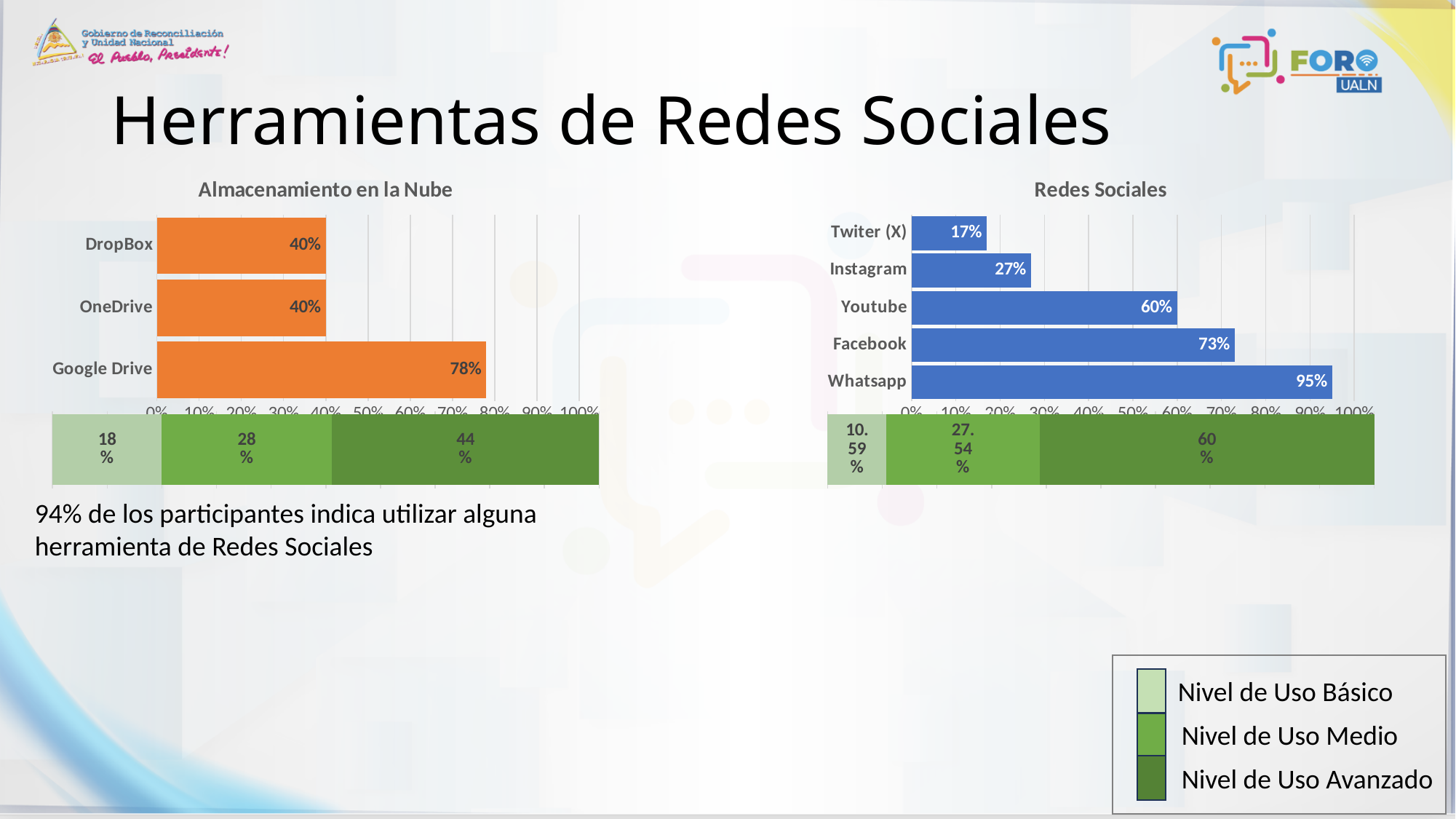
In the 'Redes Sociales' chart, what is the value for Instagram? 27% In the 'Redes Sociales' chart, what is the difference between Whatsapp and Youtube? 35% In the 'Almacenamiento en la Nube' chart, what is the difference between Google Drive and DropBox? 38% In the 'Almacenamiento en la Nube' chart, what is the value for Google Drive? 78% In the 'Redes Sociales' chart, which category has the highest value? Whatsapp In the 'Redes Sociales' chart, what is the value for Facebook? 73% In the 'Redes Sociales' chart, which category has the lowest value? Twiter (X) In the 'Redes Sociales' chart, which is larger, Youtube or Facebook? Facebook In the 'Almacenamiento en la Nube' chart, what is the value for OneDrive? 40% What kind of chart is the 'Redes Sociales' chart? Bar chart In the 'Almacenamiento en la Nube' chart, which category has the highest value? Google Drive How many categories are shown in the 'Almacenamiento en la Nube' chart? 3